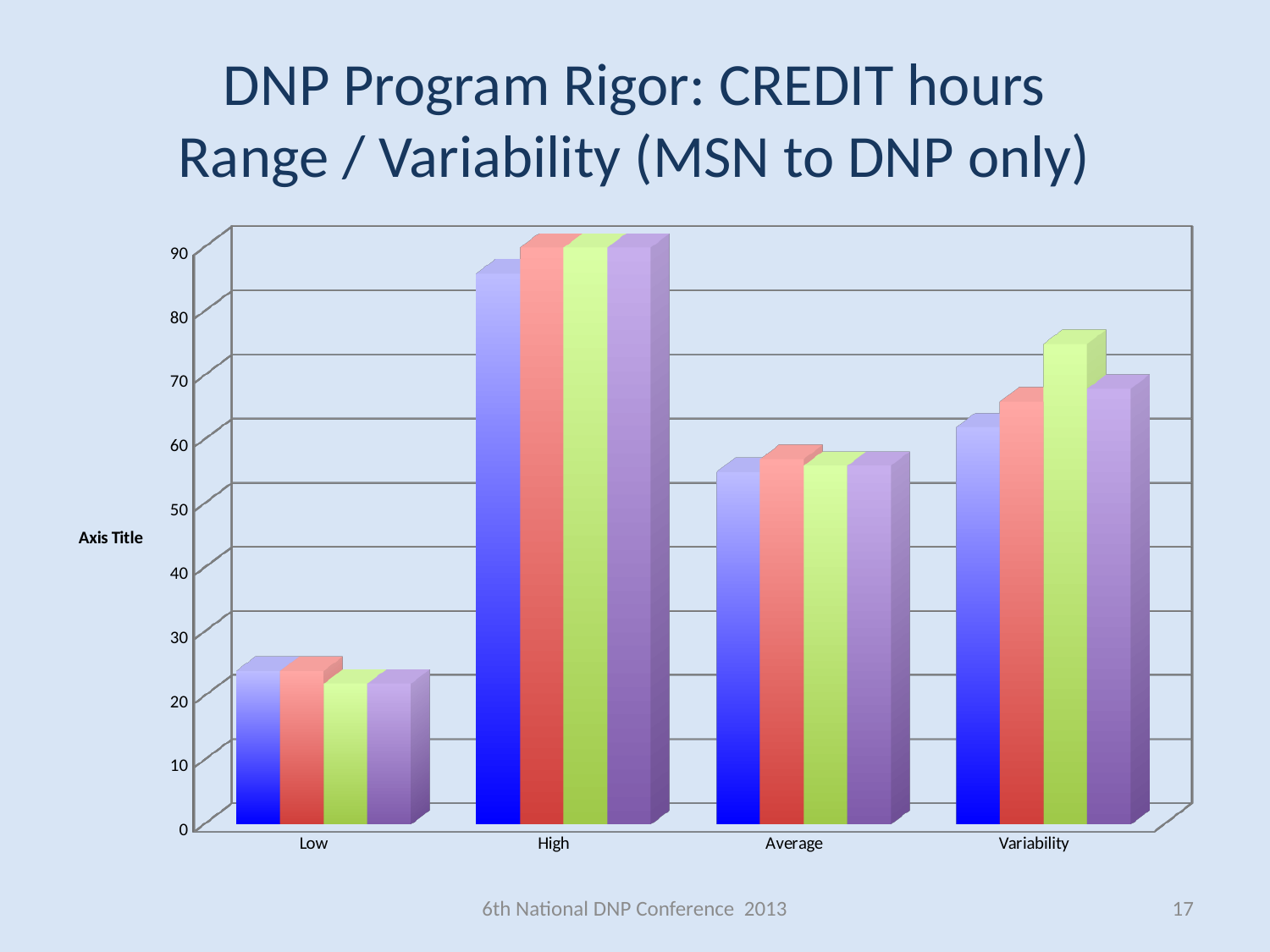
Which category has the tallest bars in the chart? High Is the value of the blue bar for Average greater or less than 50? greater Which category has the shortest bars in the chart? Low Which is larger, the blue bar for High or the blue bar for Average? High Within the Variability category, which is larger, the green bar or the blue bar? the green bar What is the label shown on the vertical axis of the chart? Axis Title Is the value of the green bar for Variability greater or less than 70? greater What kind of chart is shown on the slide? bar chart How many categories are shown on the x axis of the chart? 4 Is the value of the blue bar for Low greater or less than 30? less